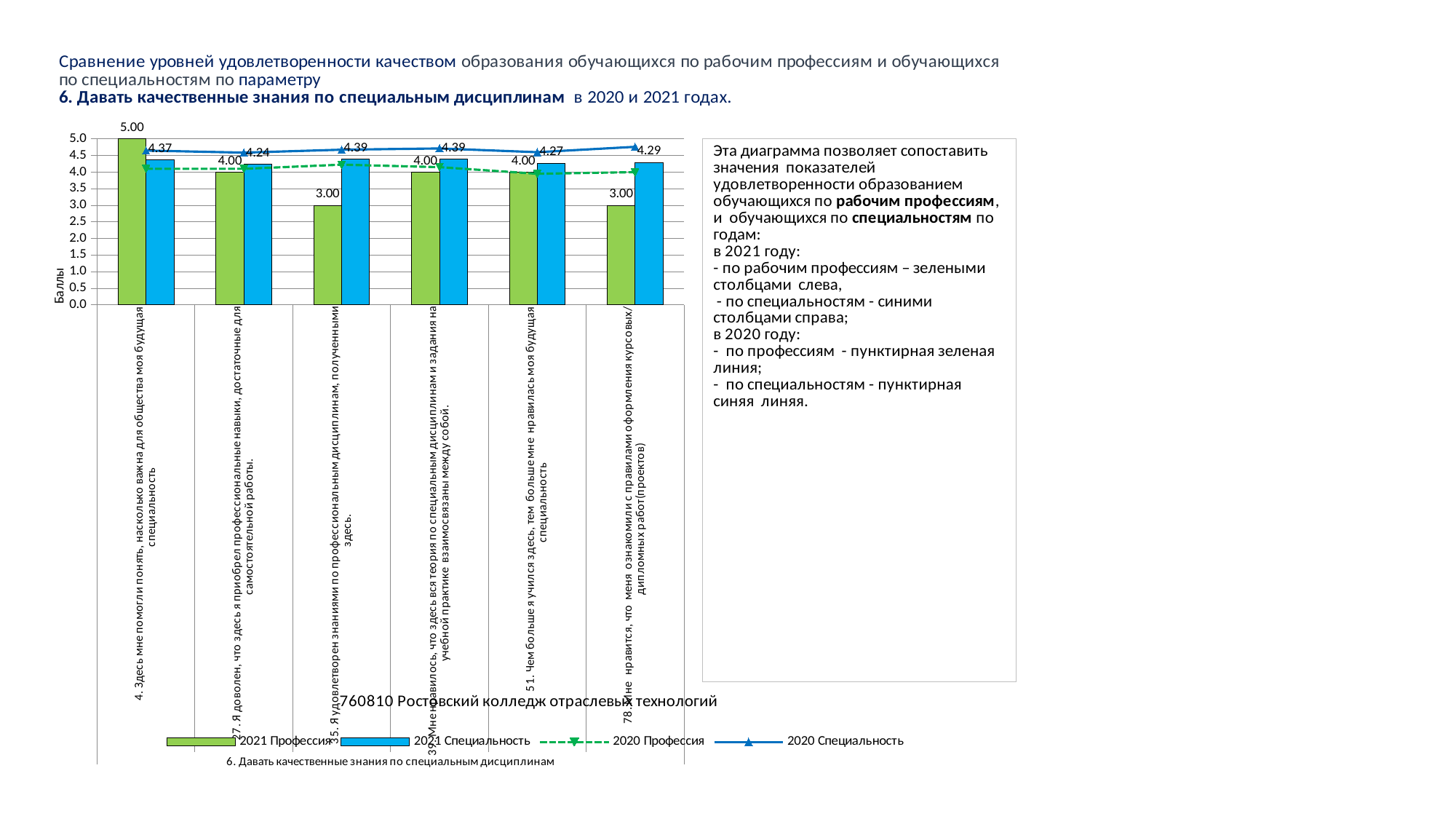
What is the value of the 2021 Специальность bar for category 78 (Мне нравится, что меня ознакомили с правилами оформления курсовых/дипломных работ)? 4.29 Is the 2020 Специальность line value for category 4 greater or less than 4.0? greater What is the title of the vertical axis of the chart? Баллы How many series does the chart legend list? 4 Which category has the highest 2021 Профессия bar? 4. Здесь мне помогли понять, насколько важна для общества моя будущая специальность How many categories are shown on the x axis of the chart? 6 What is the value of the 2021 Специальность bar for category 35 (Я удовлетворен знаниями по профессиональным дисциплинам, полученными здесь)? 4.39 Which category has the lowest 2021 Специальность bar? 27. Я доволен, что здесь я приобрел профессиональные навыки, достаточные для самостоятельной работы For category 51, which is larger: the 2021 Профессия bar or the 2021 Специальность bar? 2021 Специальность For category 35, what is the difference between the 2021 Специальность bar and the 2021 Профессия bar? 1.39 What is the value of the 2021 Профессия bar for category 4 (Здесь мне помогли понять, насколько важна для общества моя будущая специальность)? 5.00 For category 4, what is the difference between the 2021 Профессия bar and the 2021 Специальность bar? 0.63